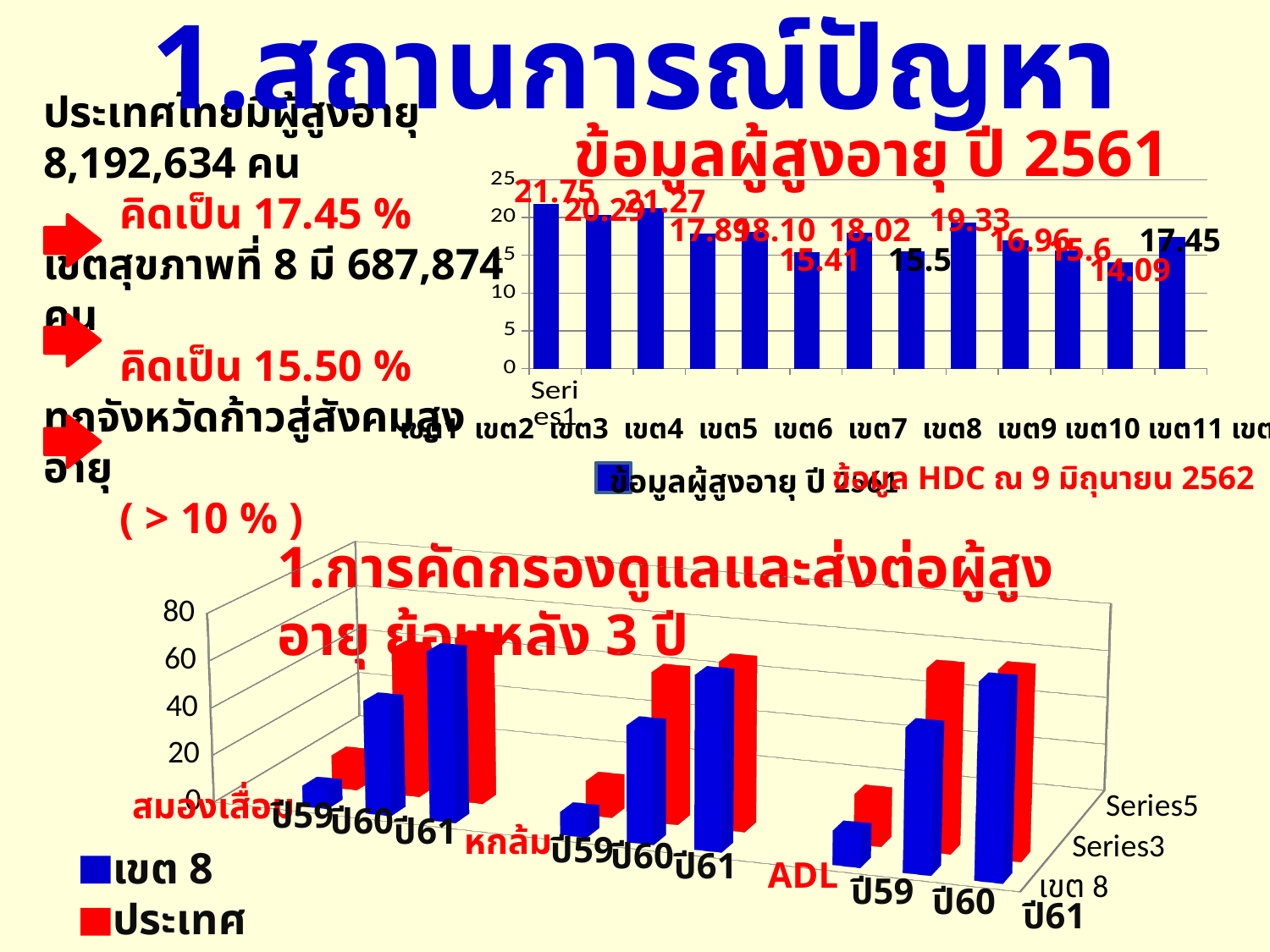
What kind of chart is the bottom chart '1.การคัดกรองดูแลและส่งต่อผู้สูงอายุ ย้อนหลัง 3 ปี'? bar chart In the top chart 'ข้อมูลผู้สูงอายุ ปี 2561', what is the value for เขต9? 19.33 What kind of chart is the top chart 'ข้อมูลผู้สูงอายุ ปี 2561'? bar chart In the bottom chart '1.การคัดกรองดูแลและส่งต่อผู้สูงอายุ ย้อนหลัง 3 ปี', which series is shown in red? ประเทศ In the top chart 'ข้อมูลผู้สูงอายุ ปี 2561', what is the value for เขต8? 15.5 In the top chart 'ข้อมูลผู้สูงอายุ ปี 2561', what is the difference between the values for เขต1 and เขต8? 6.25 In the top chart 'ข้อมูลผู้สูงอายุ ปี 2561', which is larger, the value for เขต2 or เขต3? เขต3 In the top chart 'ข้อมูลผู้สูงอายุ ปี 2561', what is the value for เขต1? 21.75 In the top chart 'ข้อมูลผู้สูงอายุ ปี 2561', which region has the highest value? เขต1 How many series does the legend of the bottom chart '1.การคัดกรองดูแลและส่งต่อผู้สูงอายุ ย้อนหลัง 3 ปี' list? 2 How many series does the legend of the top chart 'ข้อมูลผู้สูงอายุ ปี 2561' list? 1 In the top chart 'ข้อมูลผู้สูงอายุ ปี 2561', is the value for เขต6 greater or less than 20? less